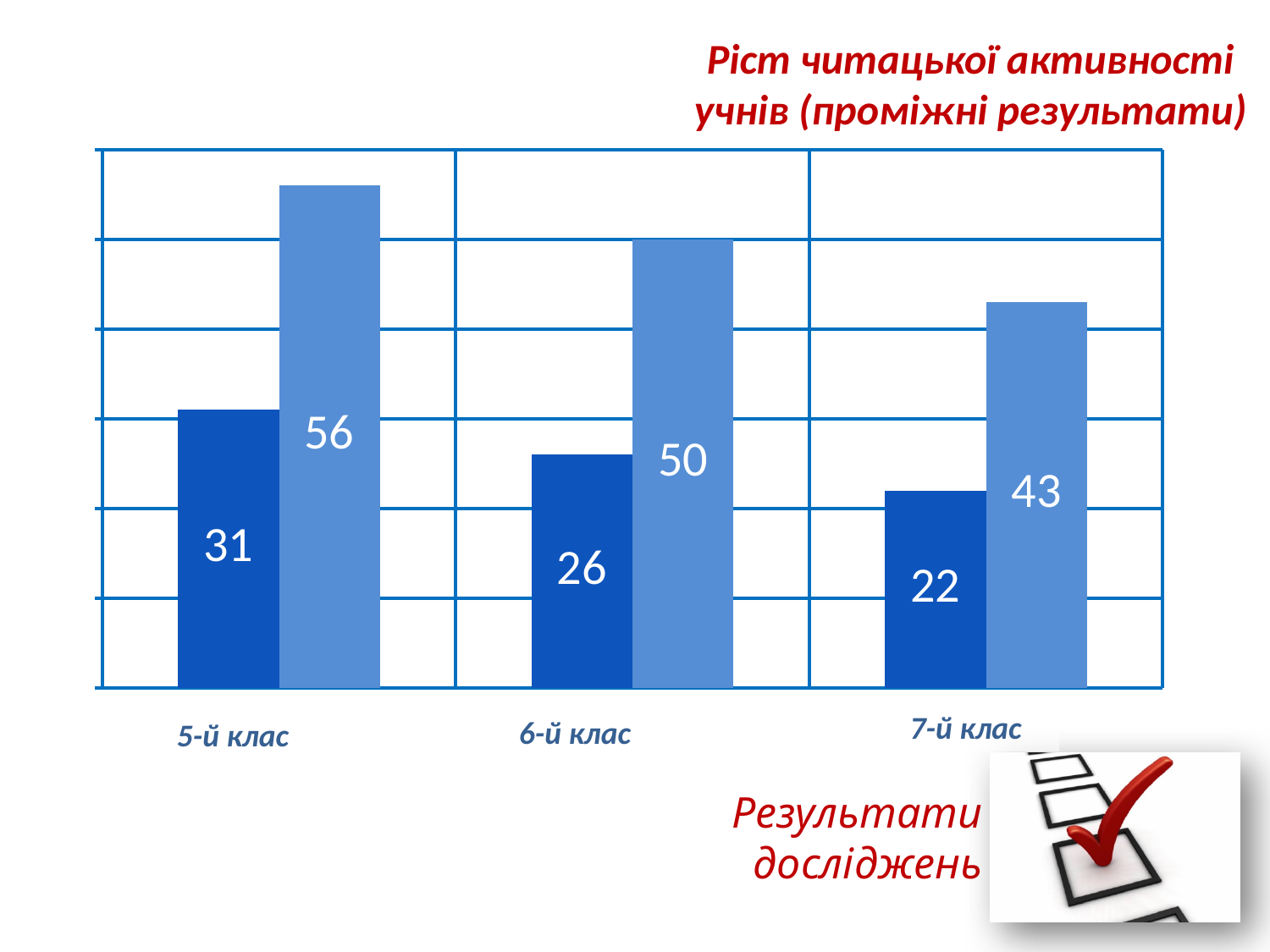
What is the value of the dark blue bar for 7-й клас? 22 What is the value of the light blue bar for 7-й клас? 43 What is the value of the dark blue bar for 5-й клас? 31 Which category has the lowest dark blue bar? 7-й клас What is the difference between the light blue and dark blue bars for 5-й клас? 25 What is the difference between the dark blue values for 6-й клас and 7-й клас? 4 What is the value of the light blue bar for 6-й клас? 50 How many categories are shown on the x axis? 3 What kind of chart is shown on the slide? bar chart Which is larger: the light blue bar for 7-й клас or the dark blue bar for 5-й клас? the light blue bar for 7-й клас Which category has the highest light blue bar? 5-й клас Do the dark blue values rise or fall from 5-й клас to 7-й клас? fall